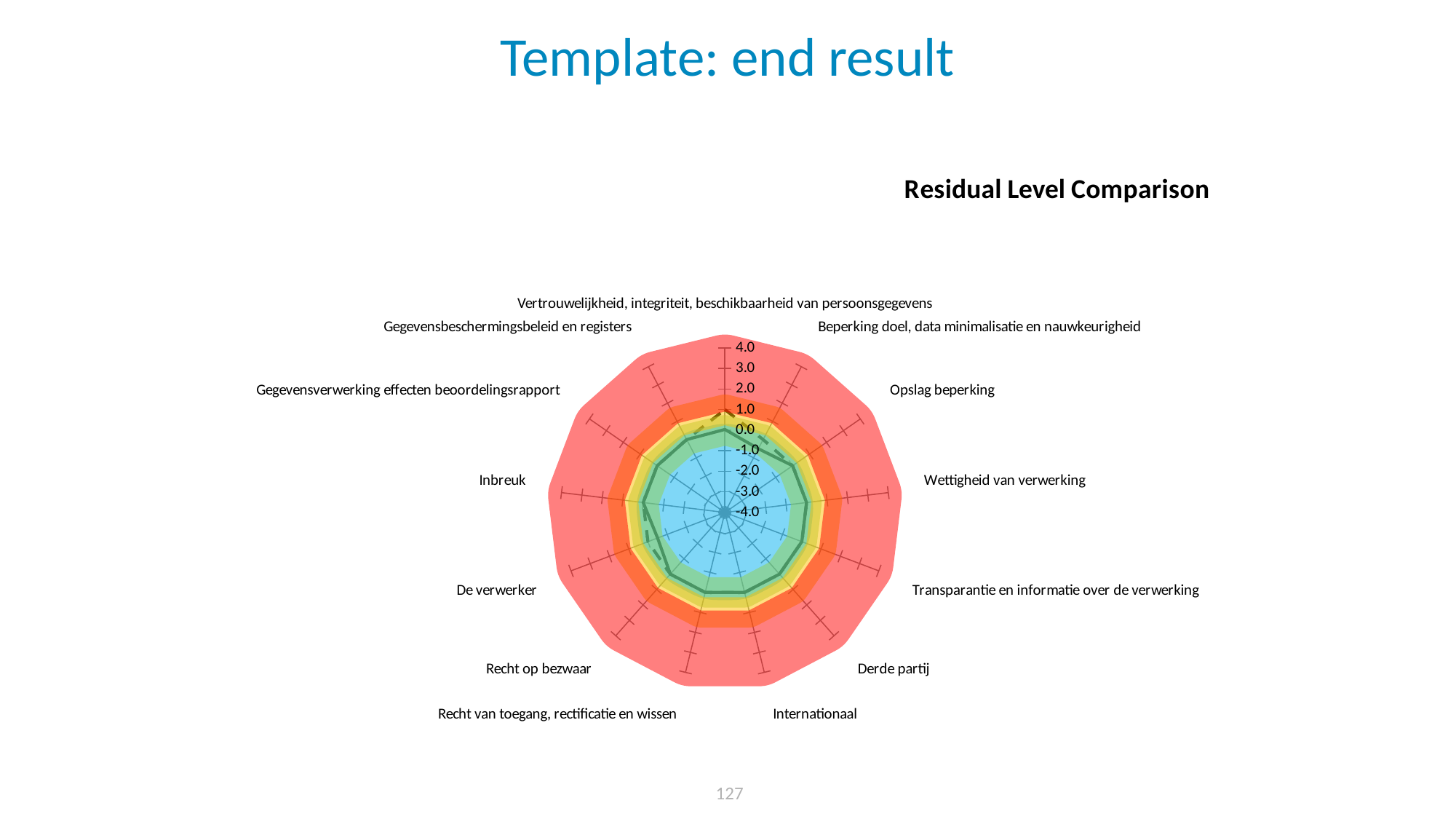
Is the solid line's value for Derde partij greater or less than 3.0? less What is the highest value shown on the chart's radial axis? 4.0 Is the dashed line's value for Vertrouwelijkheid, integriteit, beschikbaarheid van persoonsgegevens greater or less than 0.0? greater Is the solid line's value for Wettigheid van verwerking greater or less than 2.0? less What is the lowest value shown on the chart's radial axis? -4.0 Which category label appears at the top of the radar chart? Vertrouwelijkheid, integriteit, beschikbaarheid van persoonsgegevens What is the title of the chart? Residual Level Comparison How many categories (axes) does the radar chart have? 13 What kind of chart is shown on the slide? Radar chart